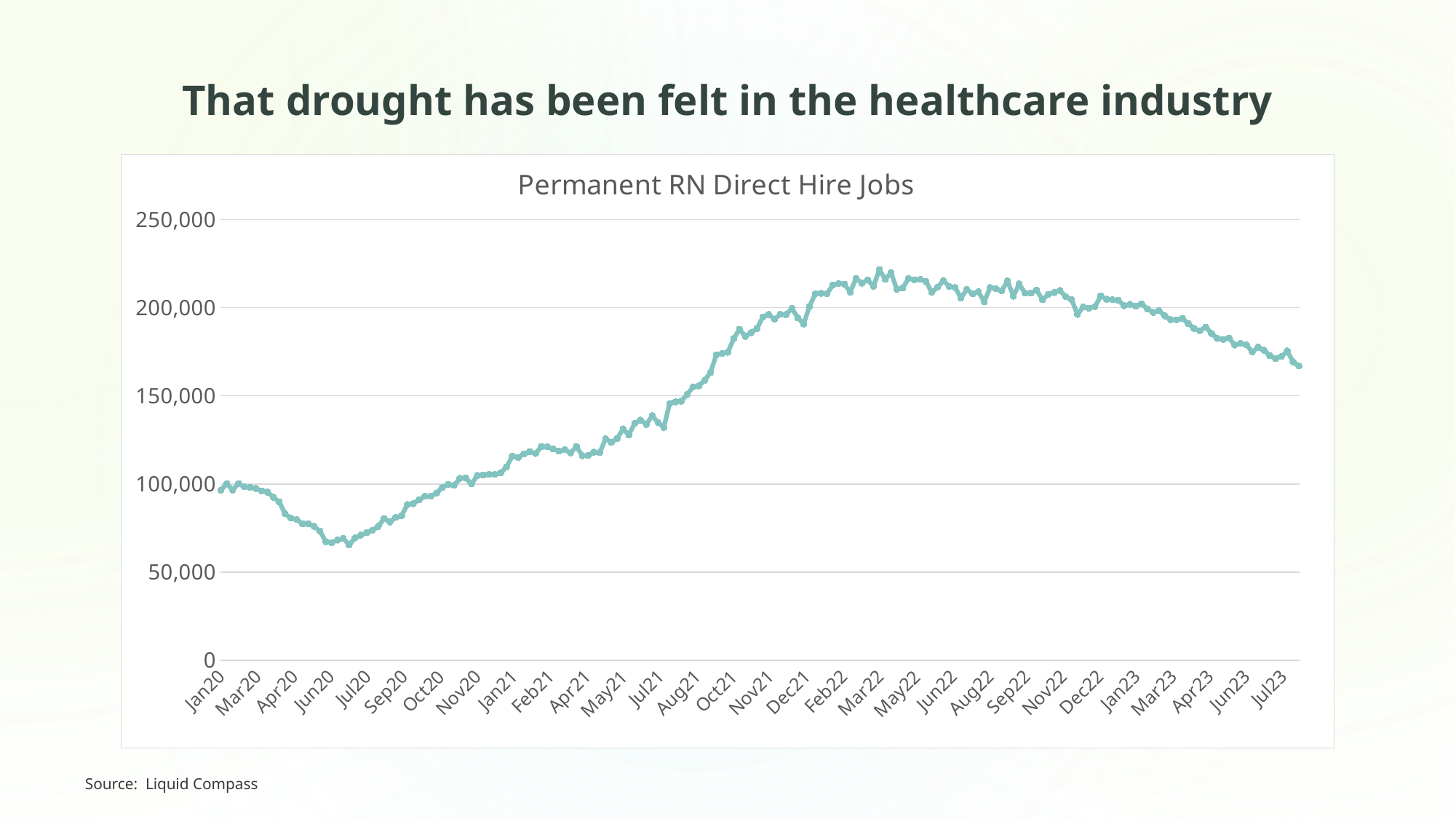
What source is cited for the chart? Liquid Compass What is the title of the chart? Permanent RN Direct Hire Jobs Is the value for Jul23 greater or less than 200,000? less Around which month does the line reach its lowest point? Jun20 What kind of chart is shown on the slide? line chart Is the value for Jul21 greater or less than 150,000? less Which is larger, the value for Jul23 or the value for Jan20? Jul23 Is the value for Oct21 greater or less than 150,000? greater Does the line rise or fall between Jun20 and Mar22? rise Which is larger, the value for Mar22 or the value for Jun20? Mar22